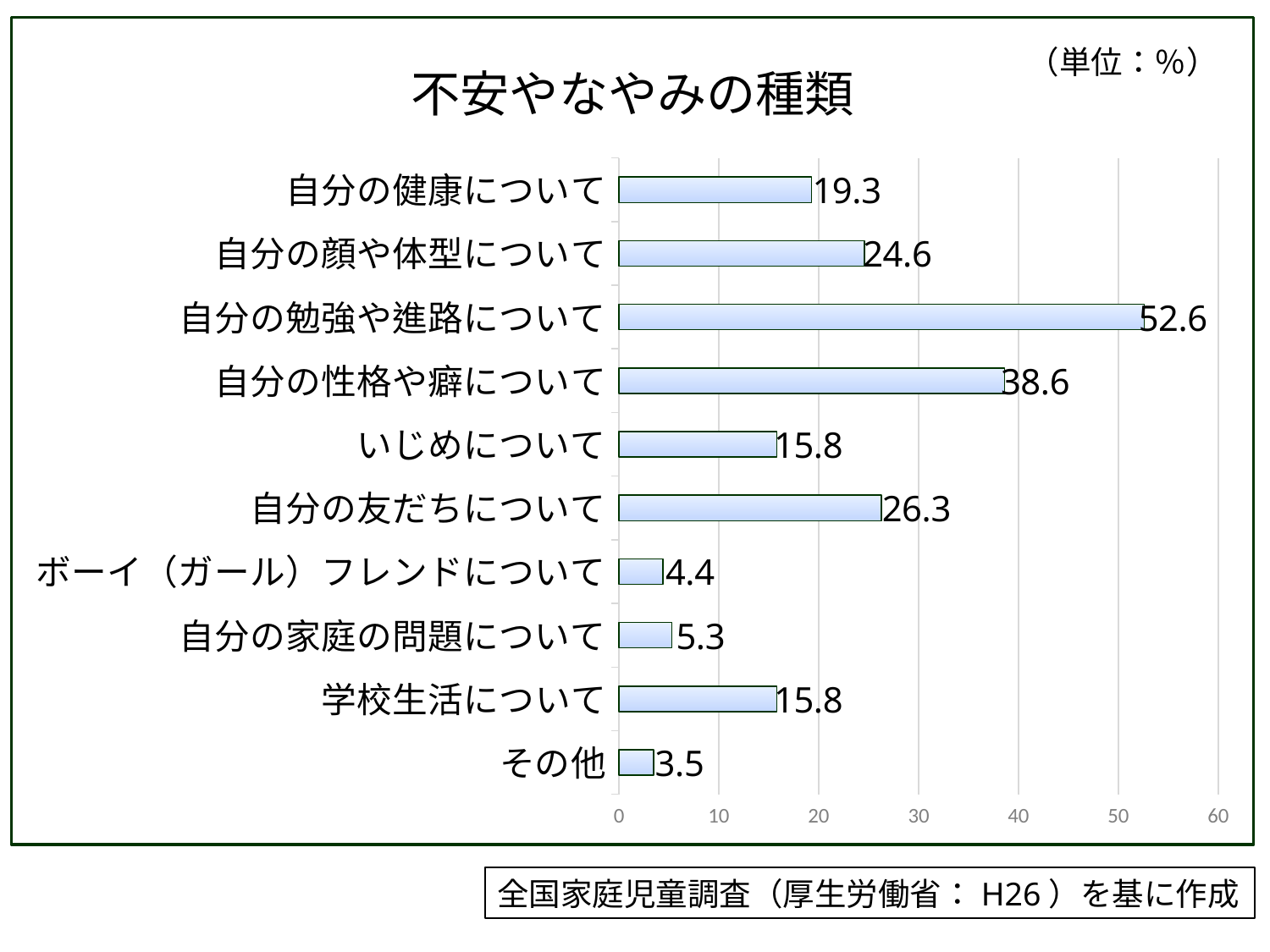
Which category has the lowest value? その他 What is the value for 自分の勉強や進路について? 52.6 What kind of chart is shown on the slide? bar chart Which category has the highest value? 自分の勉強や進路について What is the value for ボーイ（ガール）フレンドについて? 4.4 What is the title of the chart? 不安やなやみの種類 What is the value for 自分の友だちについて? 26.3 What is the difference between 自分の顔や体型について and 自分の健康について? 5.3 What is the difference between 自分の勉強や進路について and 自分の性格や癖について? 14.0 Which is larger, 自分の友だちについて or 自分の顔や体型について? 自分の友だちについて How many categories are shown in the chart? 10 Is the value for 自分の性格や癖について greater or less than 30? greater